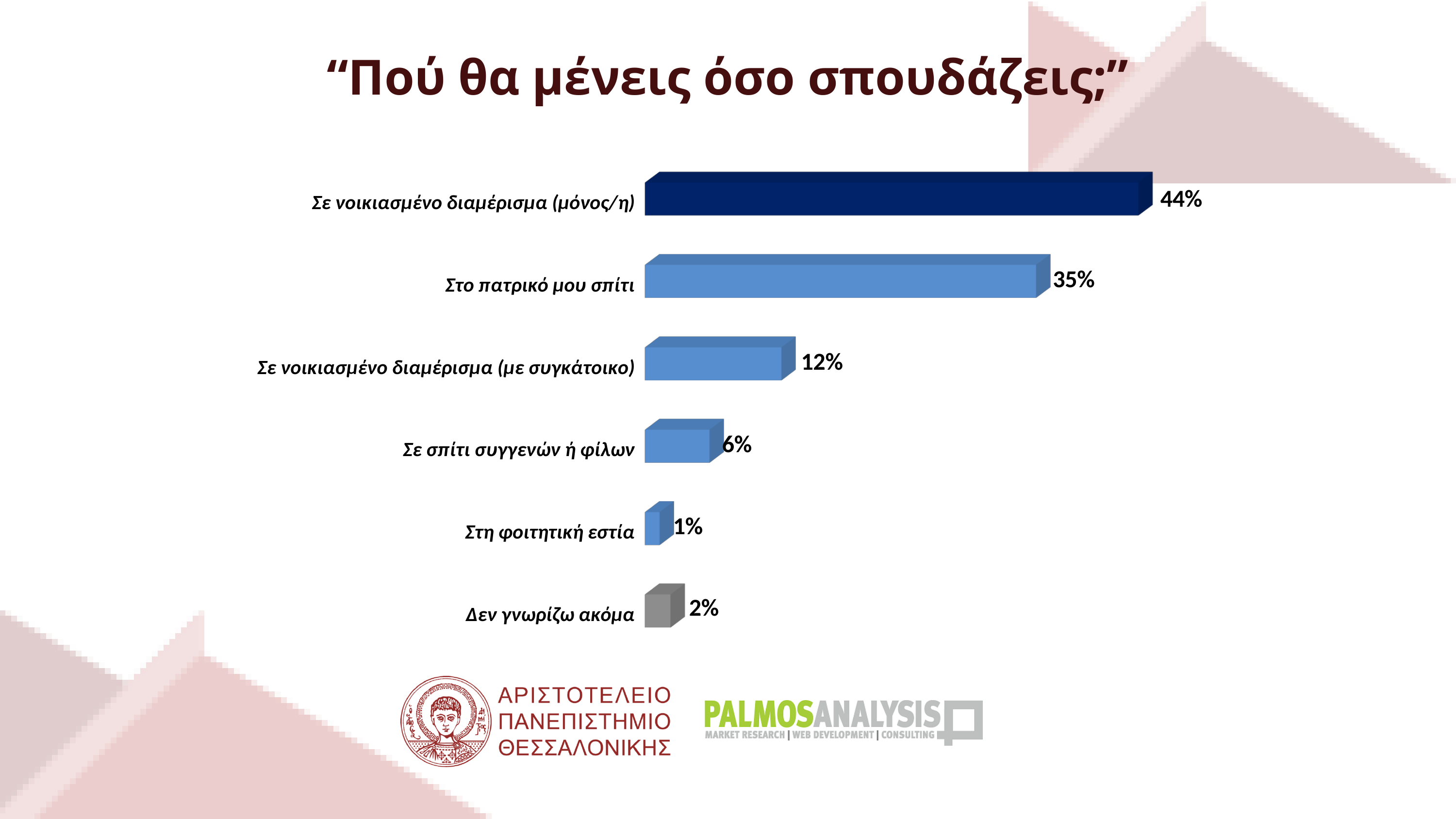
What is the value for "Δεν γνωρίζω ακόμα"? 2% How many categories are shown in the chart? 6 What is the value for "Στη φοιτητική εστία"? 1% What is the title of the slide? "Πού θα μένεις όσο σπουδάζεις;" What is the value for "Σε νοικιασμένο διαμέρισμα (με συγκάτοικο)"? 12% Which category has the highest value? Σε νοικιασμένο διαμέρισμα (μόνος/η) Which category has the lowest value? Στη φοιτητική εστία What kind of chart is shown on the slide? Bar chart Which is larger: the value for "Σε σπίτι συγγενών ή φίλων" or the value for "Δεν γνωρίζω ακόμα"? Σε σπίτι συγγενών ή φίλων What is the difference between the values for "Σε νοικιασμένο διαμέρισμα (μόνος/η)" and "Στο πατρικό μου σπίτι"? 9% What is the value for "Στο πατρικό μου σπίτι"? 35% What is the value for "Σε νοικιασμένο διαμέρισμα (μόνος/η)"? 44%